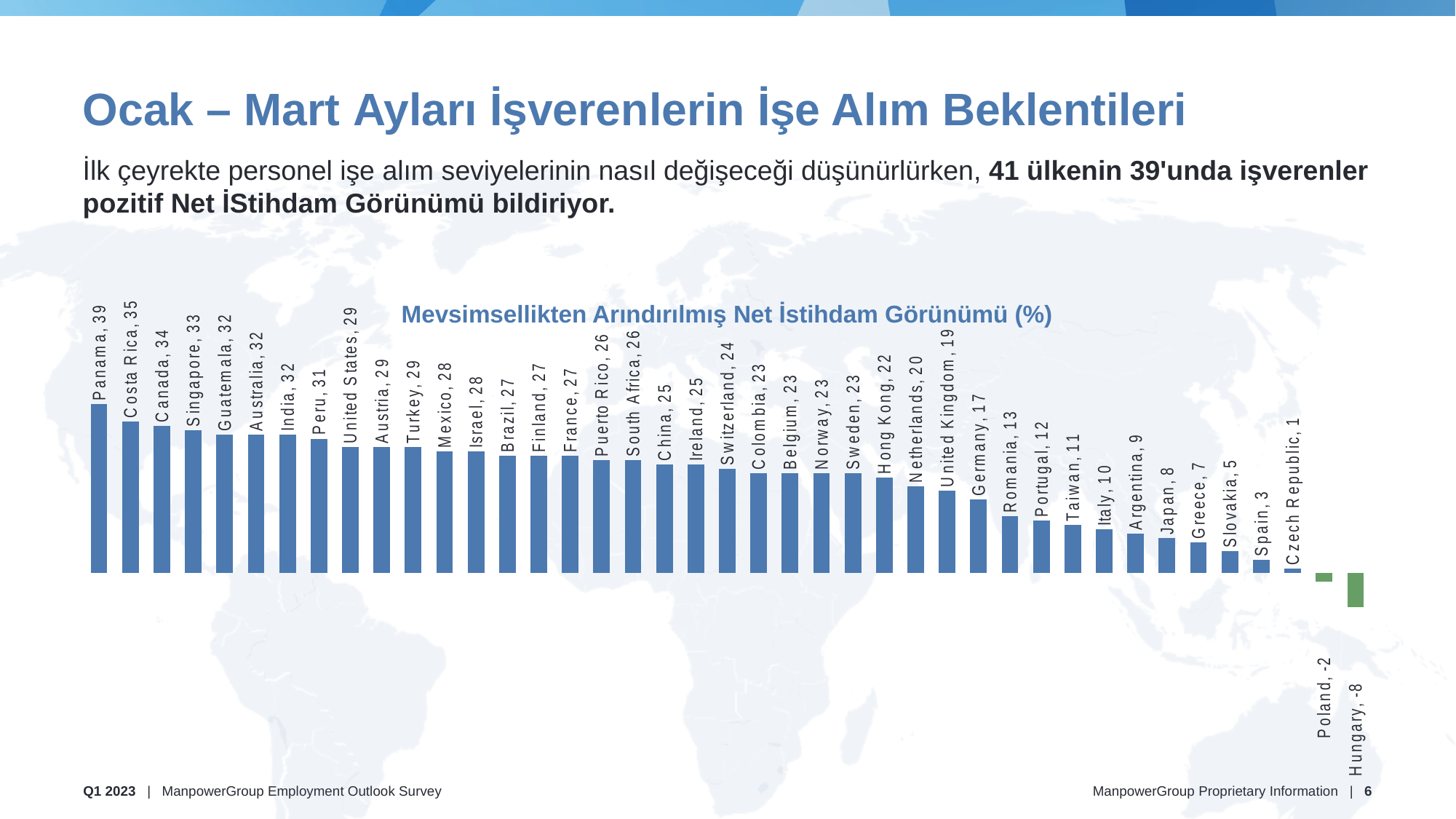
What is the Net Employment Outlook value for Panama? 39 What is the difference between the values for Panama and Costa Rica? 4 Which has a higher value, Canada or Mexico? Canada How many countries are shown on the chart? 41 What is the title of the chart? Mevsimsellikten Arındırılmış Net İstihdam Görünümü (%) What is the difference between the values for Germany and Romania? 4 What is the value shown for Hungary? -8 Which has a higher value, Japan or Portugal? Portugal What is the value shown for Turkey? 29 Which country has the lowest Net Employment Outlook on the chart? Hungary Which country has the highest Net Employment Outlook on the chart? Panama What type of chart is shown on the slide? Bar chart